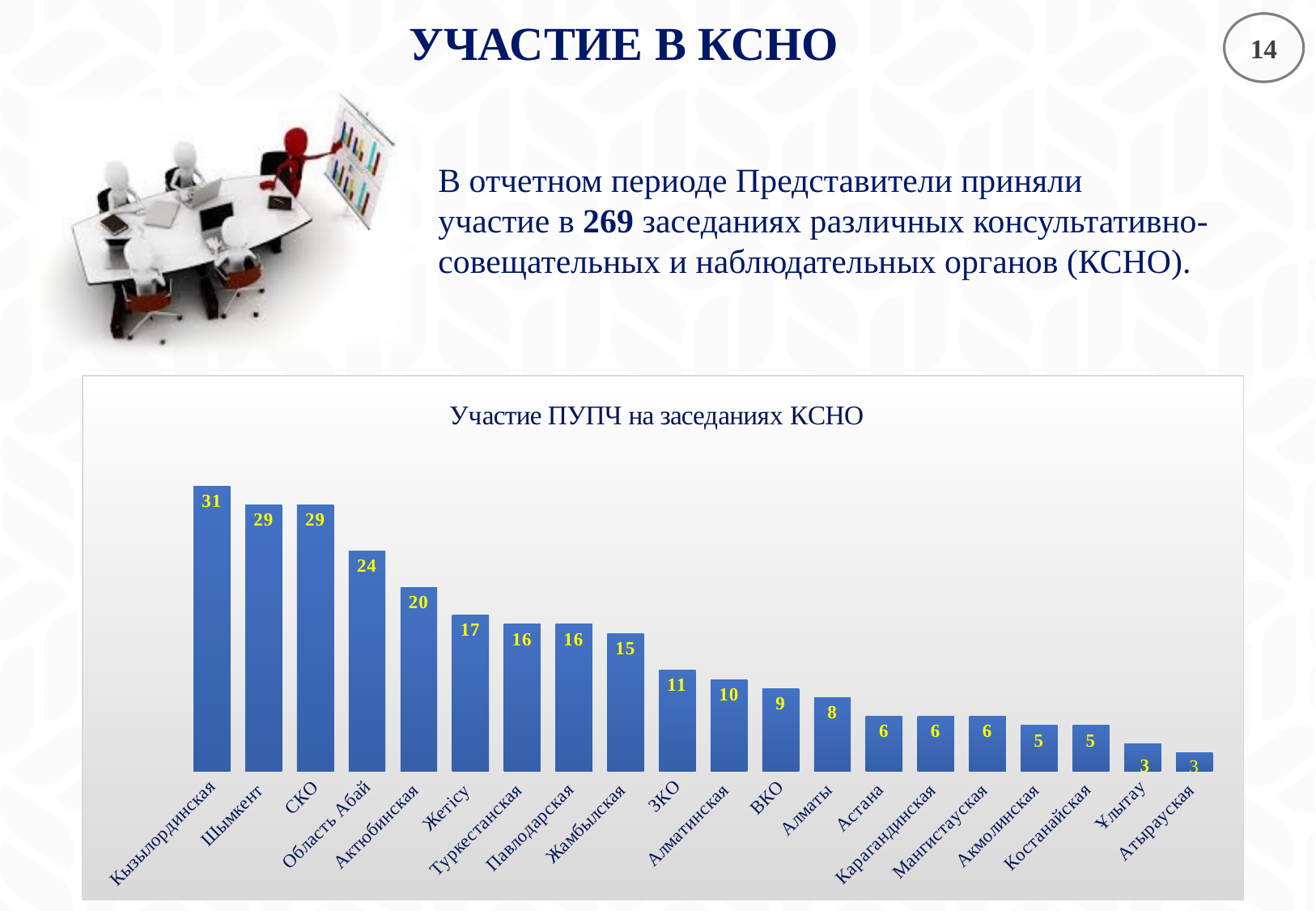
Which is larger, the value for Шымкент or the value for Область Абай? Шымкент What is the difference between the values for Кызылординская and Актюбинская? 11 Which is larger, the value for Жамбылская or the value for Алматинская? Жамбылская What is the value for Область Абай? 24 What is the value for Кызылординская in the chart? 31 What is the value for Алматы? 8 What is the difference between the values for ЗКО and ВКО? 2 What kind of chart is shown on the slide? Bar chart What is the title of the chart? Участие ПУПЧ на заседаниях КСНО What is the value for Жетісу? 17 Which category has the highest value in the chart? Кызылординская How many categories are shown in the chart? 20